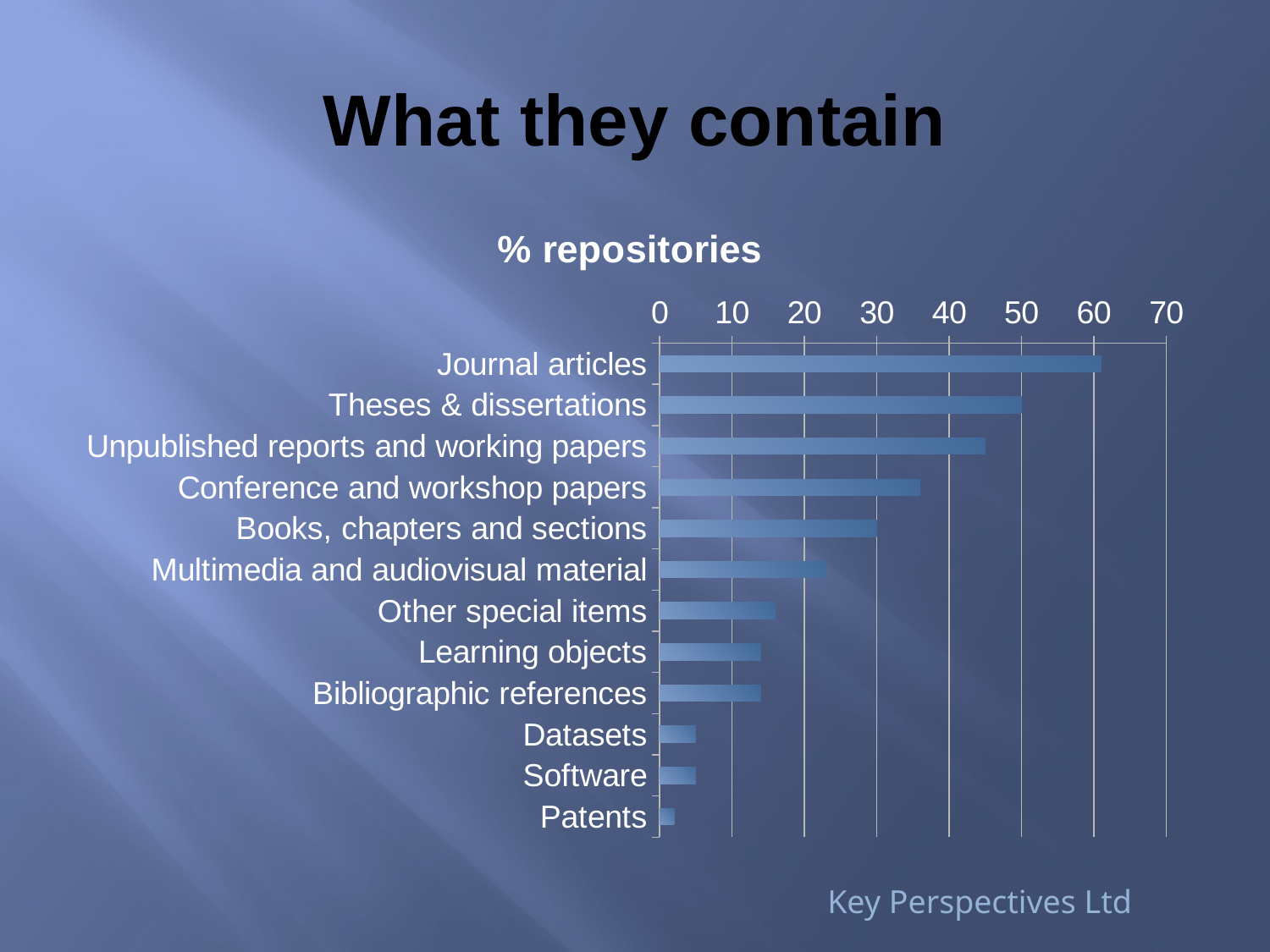
What is the title of the chart? % repositories Which category has the lowest value? Patents Is the value for Unpublished reports and working papers greater or less than 40? greater Is the value for Datasets greater or less than 10? less How many categories are plotted in the chart? 12 Which is larger, the value for Theses & dissertations or the value for Conference and workshop papers? Theses & dissertations Which category has the highest value? Journal articles Which is larger, the value for Other special items or the value for Patents? Other special items Is the value for Conference and workshop papers greater or less than 40? less What kind of chart is shown on the slide? bar chart